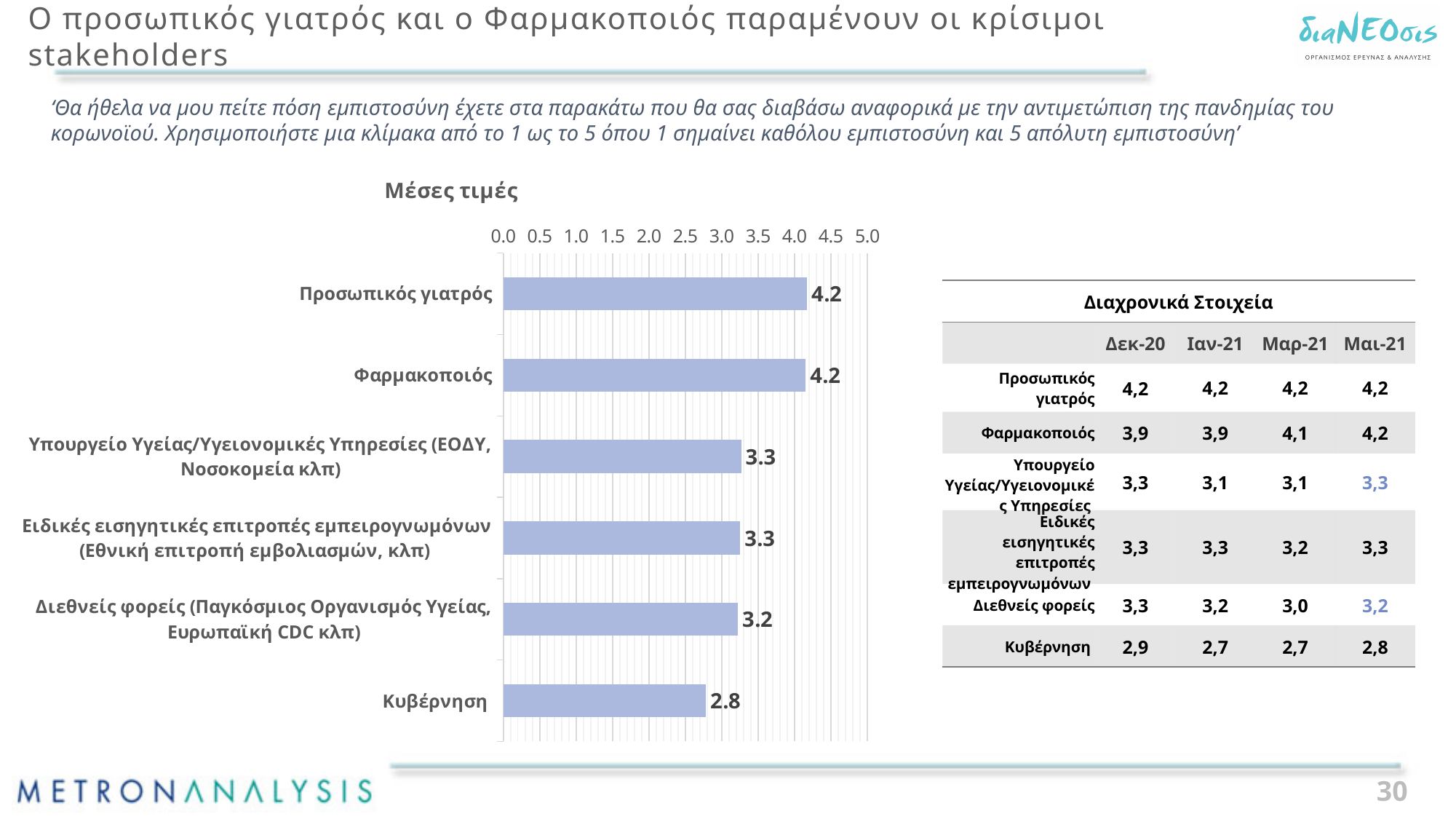
Is the value for Κυβέρνηση greater or less than 3.0? less What is the value for Προσωπικός γιατρός in the chart? 4.2 What is the value for Φαρμακοποιός in the chart? 4.2 What is the difference between the value for Φαρμακοποιός and the value for Διεθνείς φορείς? 1.0 Which category has the lowest value in the chart? Κυβέρνηση How many categories are shown in the chart? 6 What is the value for Διεθνείς φορείς (Παγκόσμιος Οργανισμός Υγείας, Ευρωπαϊκή CDC κλπ) in the chart? 3.2 Which is larger: the value for Φαρμακοποιός or the value for Κυβέρνηση? Φαρμακοποιός What is the value for Κυβέρνηση in the chart? 2.8 What is the value for Υπουργείο Υγείας/Υγειονομικές Υπηρεσίες (ΕΟΔΥ, Νοσοκομεία κλπ) in the chart? 3.3 What is the difference between the value for Προσωπικός γιατρός and the value for Κυβέρνηση? 1.4 What type of chart is shown on the slide? bar chart